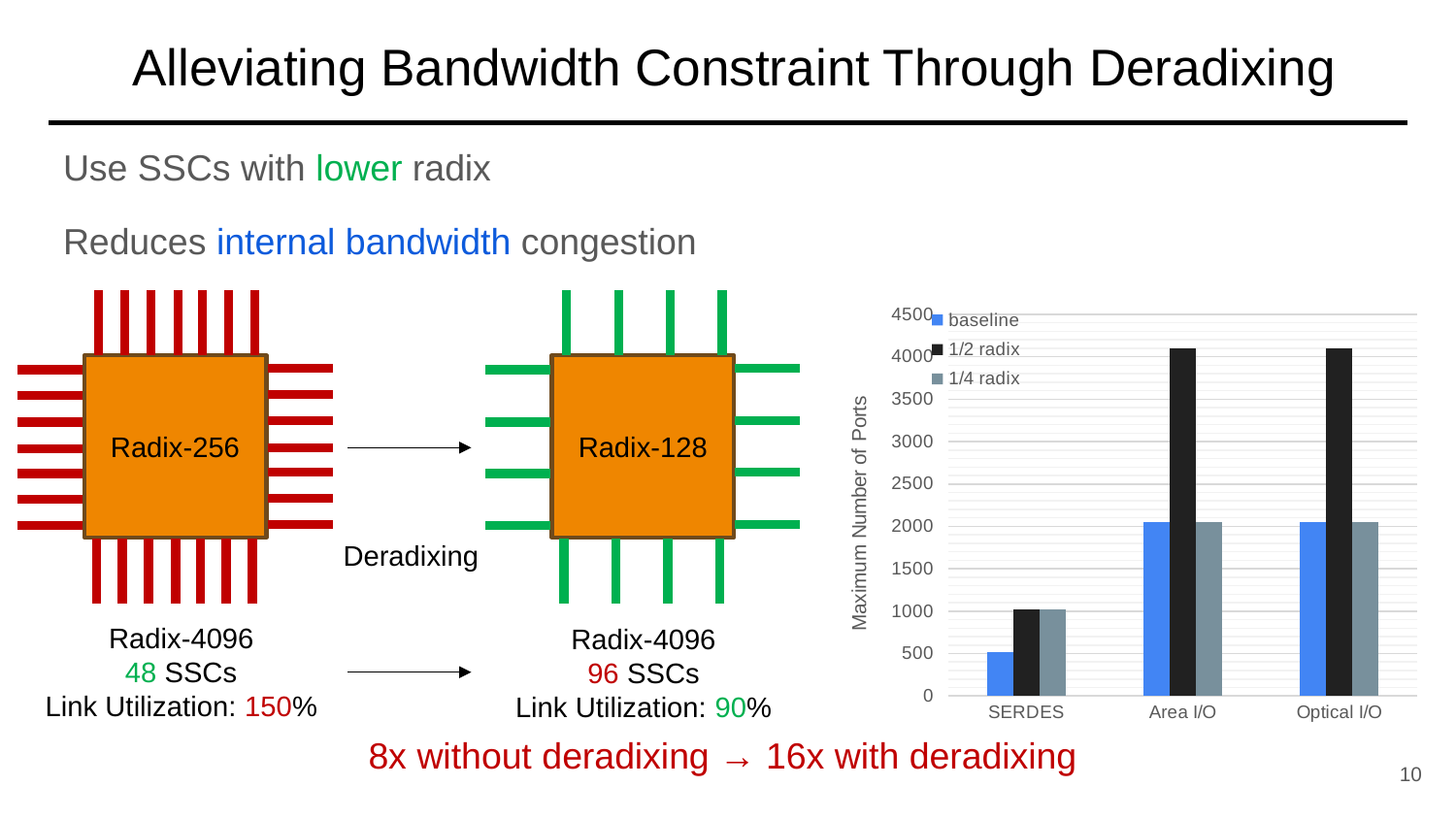
How many categories are shown on the x axis of the chart? 3 Which category has the lowest baseline value? SERDES For SERDES, which is larger: the baseline value or the 1/2 radix value? 1/2 radix For Area I/O, which series has the highest value? 1/2 radix What kind of chart is shown on the right side of the slide? bar chart Is the baseline value for Optical I/O greater or less than 2500? less Is the 1/2 radix value for Area I/O greater or less than 3500? greater What are the three series listed in the chart's legend? baseline, 1/2 radix, 1/4 radix What is the label of the chart's vertical axis? Maximum Number of Ports Is the 1/4 radix value for SERDES greater or less than 1500? less How many series does the chart's legend list? 3